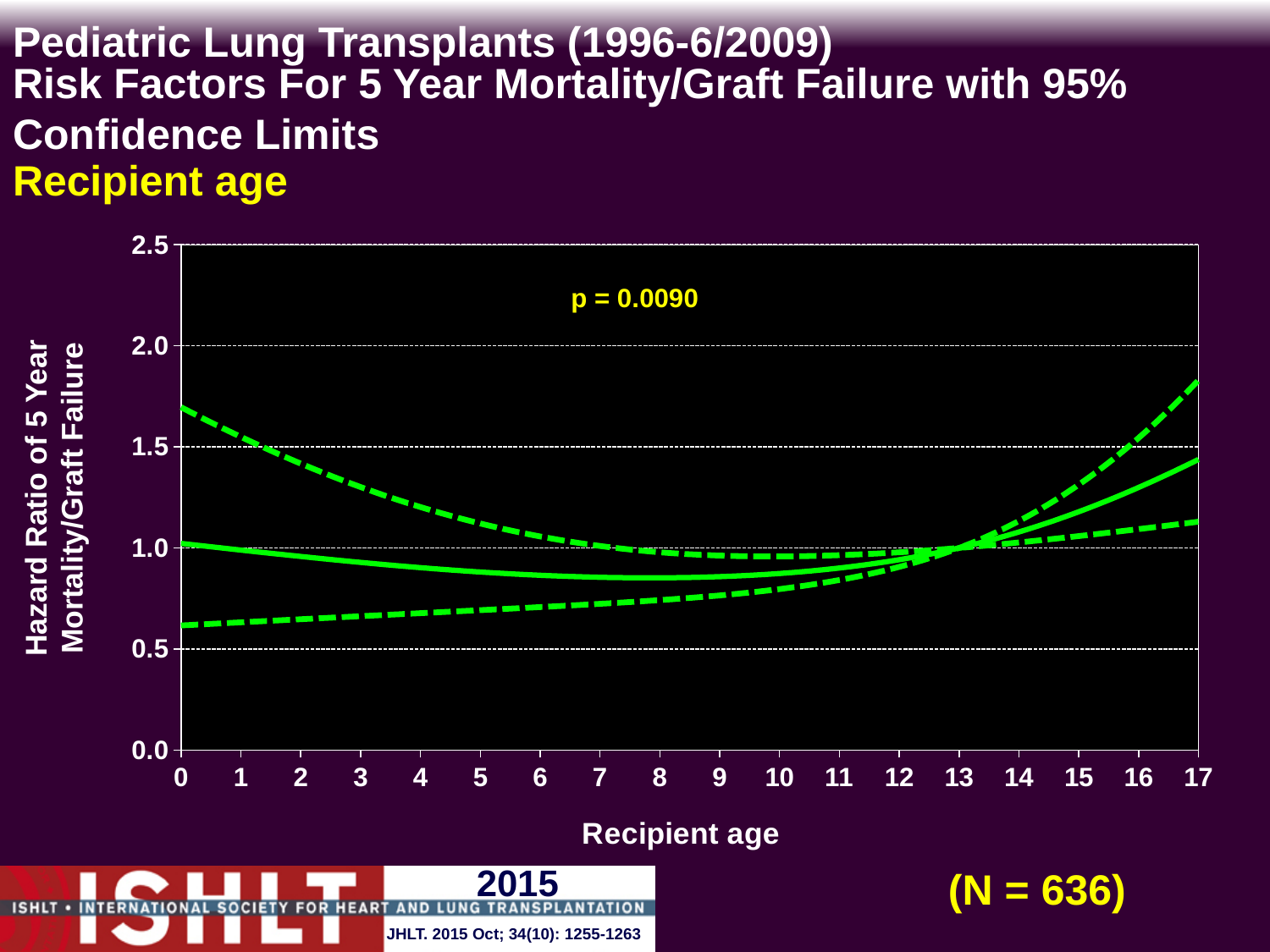
Does the hazard ratio (solid line) rise or fall as recipient age increases from 0 to 8? fall How many recipient age tick marks are labelled on the x axis? 18 What sample size (N) is shown on the slide? N = 636 Is the upper 95% confidence limit (upper dashed line) at recipient age 0 greater or less than 1.5? greater Is the hazard ratio (solid line) at recipient age 17 greater or less than 1.0? greater Is the lower 95% confidence limit (lower dashed line) at recipient age 0 greater or less than 1.0? less Does the hazard ratio (solid line) rise or fall as recipient age increases from 10 to 17? rise What kind of chart is shown on the slide? line chart What p-value is printed on the chart? p = 0.0090